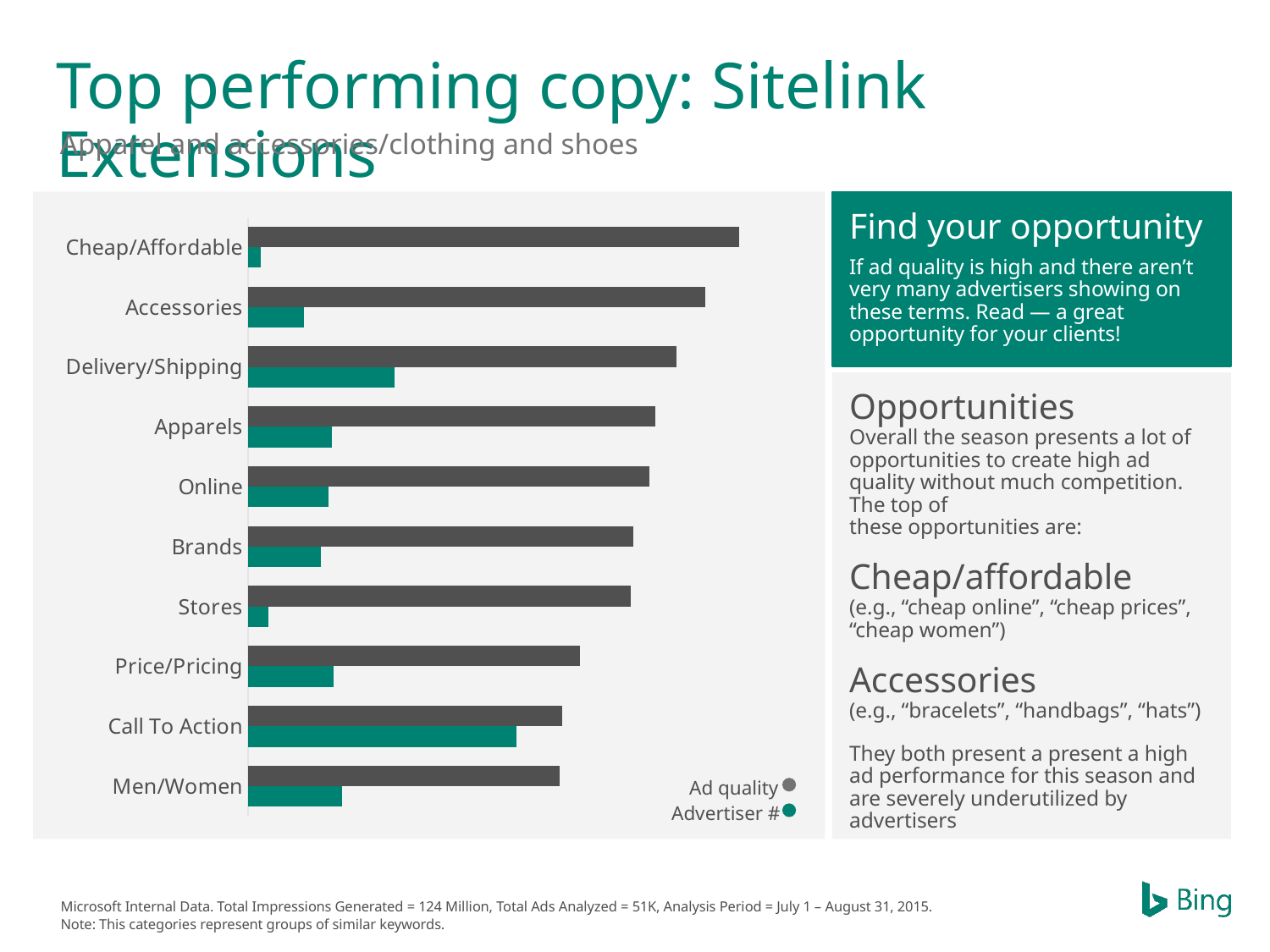
Which has the higher Ad quality value, Cheap/Affordable or Accessories? Cheap/Affordable Which has the higher Advertiser # value, Call To Action or Men/Women? Call To Action Which has the higher Ad quality value, Brands or Price/Pricing? Brands Which category has the highest Ad quality value? Cheap/Affordable Which series is shown in teal/green in the chart? Advertiser # Do the Ad quality bars generally get shorter or longer going from the top category to the bottom category? Shorter What kind of chart is shown on the slide? Bar chart Which category has the highest Advertiser # value? Call To Action How many series does the chart's legend list? 2 How many categories are plotted on the chart? 10 What are the two series named in the chart's legend? Ad quality and Advertiser #